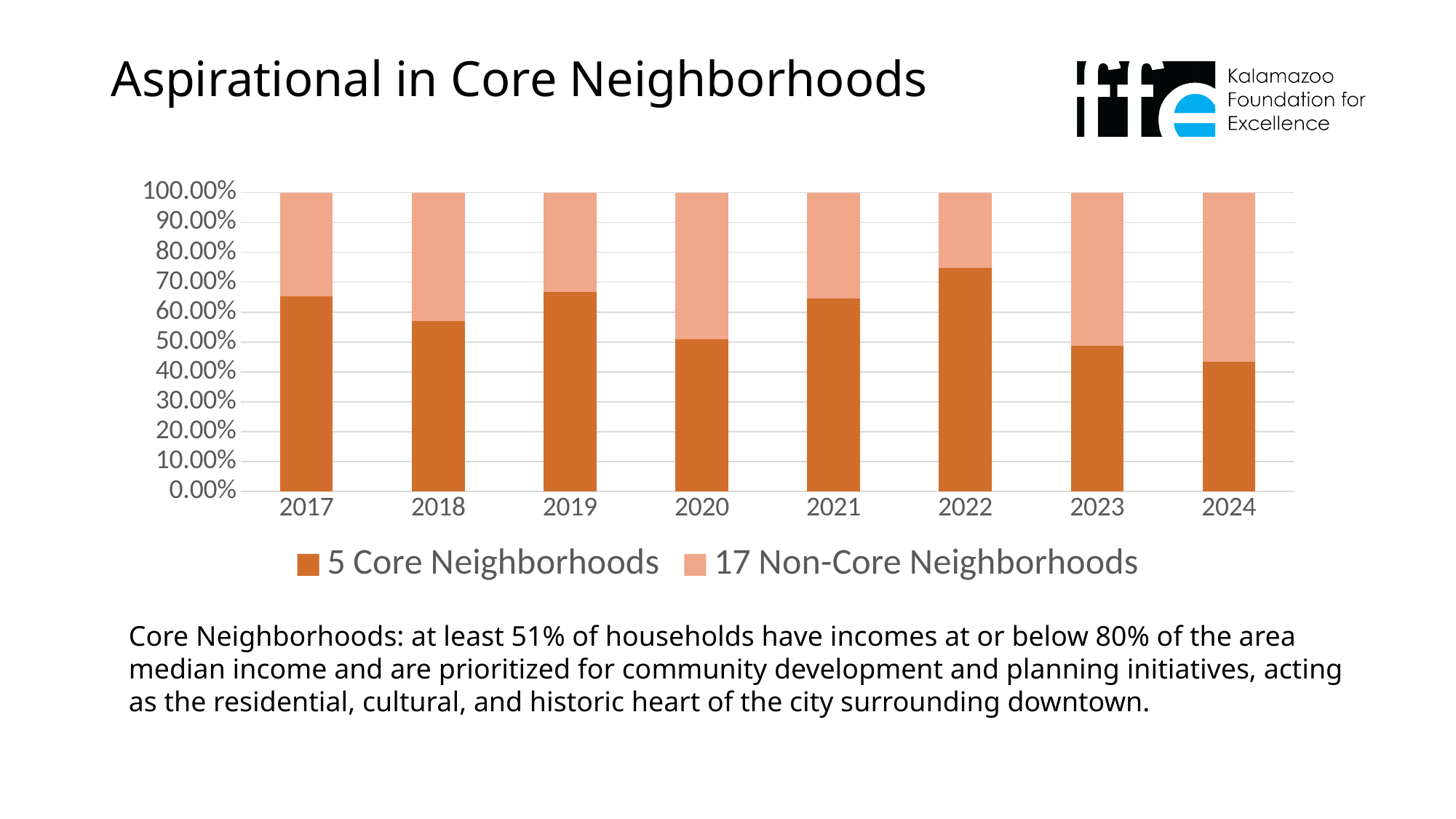
In which year is the share for 5 Core Neighborhoods the highest? 2022 In which year is the share for 5 Core Neighborhoods the lowest? 2024 Is the value for 5 Core Neighborhoods in 2022 greater or less than 70.00%? greater What are the two series named in the chart's legend? 5 Core Neighborhoods and 17 Non-Core Neighborhoods What is the total height of each stacked bar, as shown on the axis? 100.00% How many series does the chart's legend list? 2 How many years are shown on the x axis of the chart? 8 Is the value for 5 Core Neighborhoods in 2017 greater or less than 60.00%? greater Is the value for 5 Core Neighborhoods in 2024 greater or less than 50.00%? less In which year is the share for 17 Non-Core Neighborhoods the highest? 2024 Which year has a larger share for 5 Core Neighborhoods, 2017 or 2018? 2017 What kind of chart is shown on the slide? Stacked bar chart